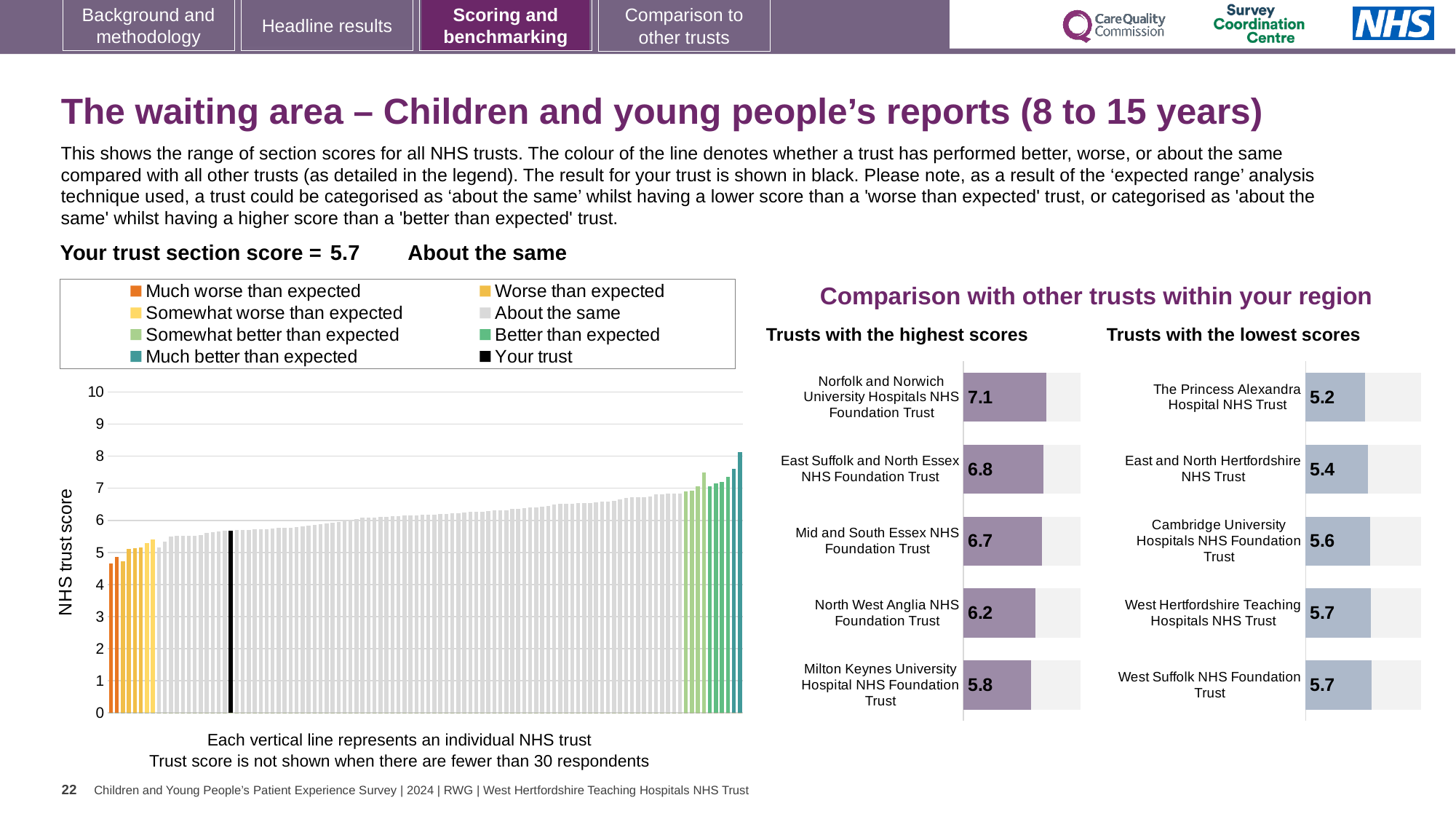
In the 'Trusts with the lowest scores' chart, what is the score for The Princess Alexandra Hospital NHS Trust? 5.2 In the 'Trusts with the highest scores' chart, what is the difference between the scores of Norfolk and Norwich University Hospitals NHS Foundation Trust and Milton Keynes University Hospital NHS Foundation Trust? 1.3 In the 'Trusts with the highest scores' chart, what is the score for Norfolk and Norwich University Hospitals NHS Foundation Trust? 7.1 In the 'Trusts with the highest scores' chart, which trust has the highest score? Norfolk and Norwich University Hospitals NHS Foundation Trust What is the section score for your trust shown on the slide? 5.7 In the 'Trusts with the lowest scores' chart, which trust has the lowest score? The Princess Alexandra Hospital NHS Trust In the main 'NHS trust score' chart, is the value of the leftmost (lowest) bar greater or less than 5? less In the 'Trusts with the highest scores' chart, which has the larger score: East Suffolk and North Essex NHS Foundation Trust or Mid and South Essex NHS Foundation Trust? East Suffolk and North Essex NHS Foundation Trust How many entries does the legend of the main NHS trust score chart list? 8 What kind of chart is the main 'NHS trust score' chart on the left? Bar chart How many trusts are listed in the 'Trusts with the highest scores' chart? 5 In the main 'NHS trust score' chart, do the bar values rise or fall from left to right? Rise